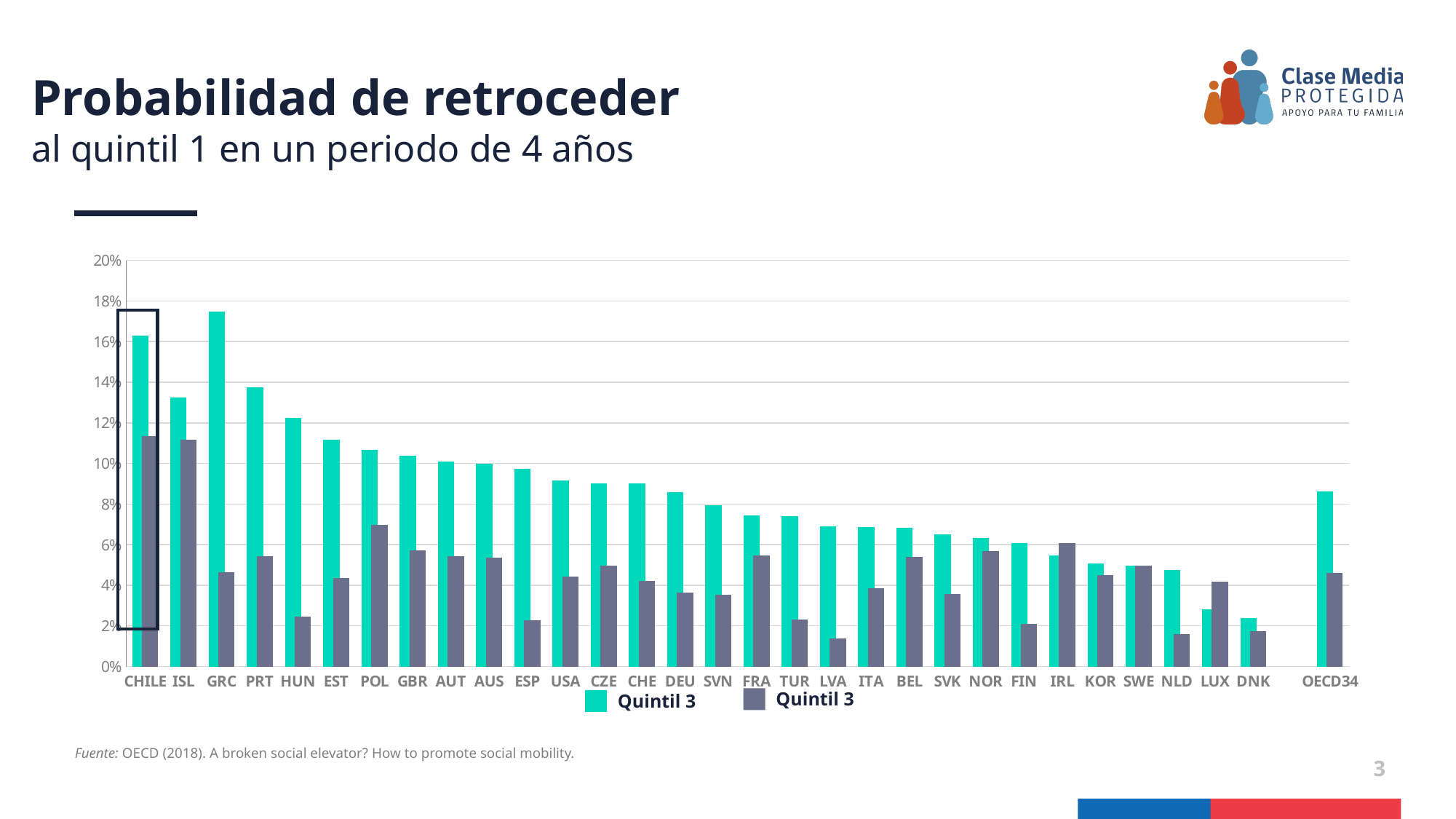
Is the grey bar for HUN greater or less than 4%? less How many series does the chart's legend list? 2 Is the teal bar for OECD34 greater or less than 8%? greater Is the teal bar for GRC greater or less than 16%? greater Which category has the highest teal (first series) bar? GRC How many categories are shown along the x axis of the chart? 31 Which has the larger teal bar, CHILE or ISL? CHILE What kind of chart is shown on the slide? bar chart Do the teal bars generally rise or fall from CHILE to DNK along the x axis? fall Which category on the chart is highlighted with a rectangular outline? CHILE